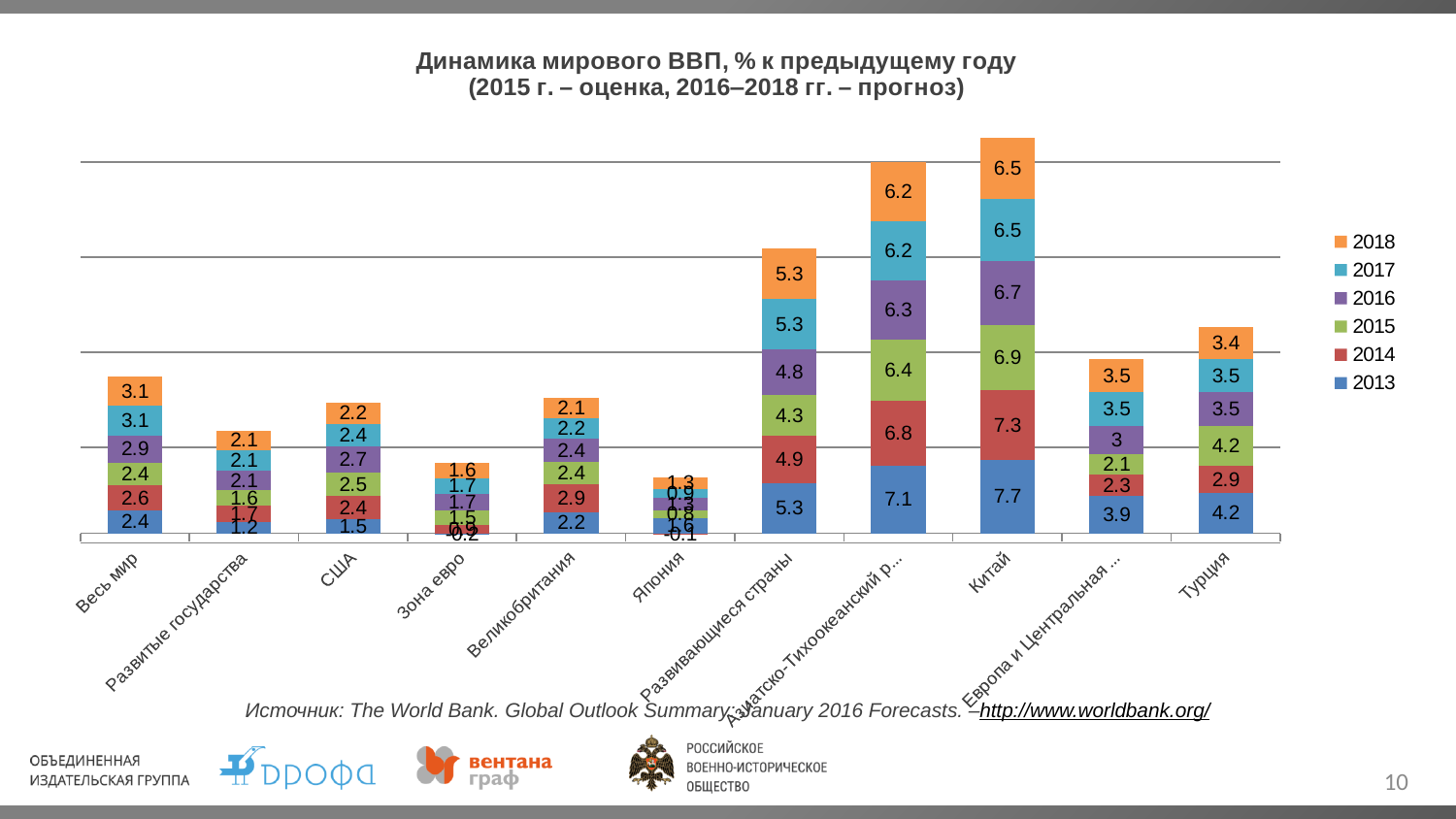
What is the 2018 value for Весь мир? 3.1 Which category has the highest 2013 value? Китай What kind of chart is shown on the slide? Stacked bar chart Which category has the tallest stacked bar overall? Китай How many categories are shown on the x axis? 11 What is the difference between the 2013 values for Китай and Весь мир? 5.3 What is the 2014 value for Турция? 2.9 Which is larger, the 2015 value for Развивающиеся страны or the 2015 value for Великобритания? Развивающиеся страны What is the 2016 value for США? 2.7 How many series does the legend list? 6 What is the 2013 value for Китай? 7.7 What is the total of the stacked bar for Весь мир? 16.5